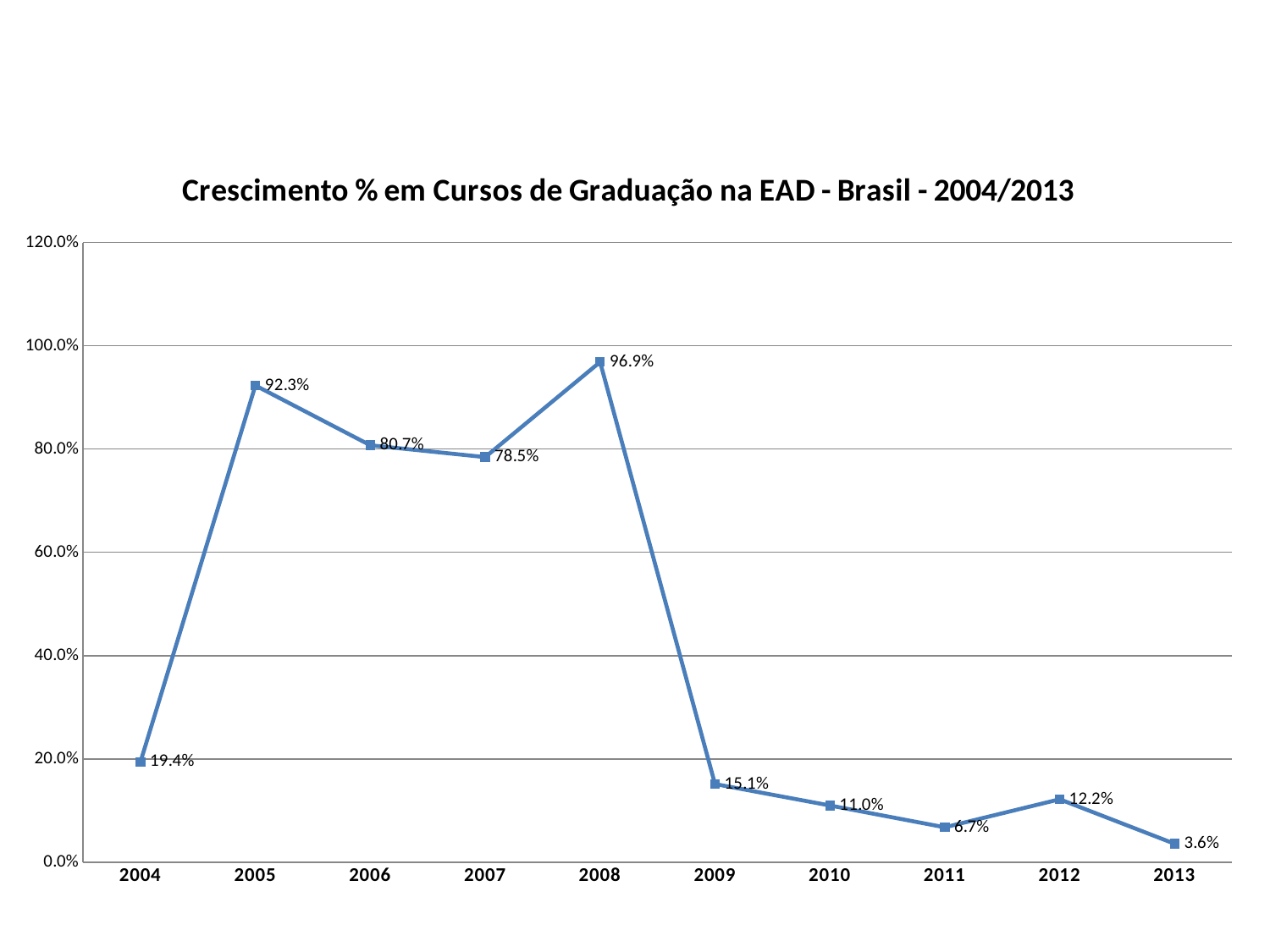
Is the value for 2007 greater or less than 80.0%? less What is the title of the chart? Crescimento % em Cursos de Graduação na EAD - Brasil - 2004/2013 What is the difference between the values for 2005 and 2006? 11.6% What is the value for 2008? 96.9% Which year has the lowest value? 2013 Which is larger, the value for 2010 or the value for 2012? 2012 What is the value for 2004? 19.4% What kind of chart is shown on the slide? line chart Do the values rise or fall from 2008 to 2009? fall What is the value for 2011? 6.7% How many years are plotted on the chart? 10 Which year has the highest value? 2008